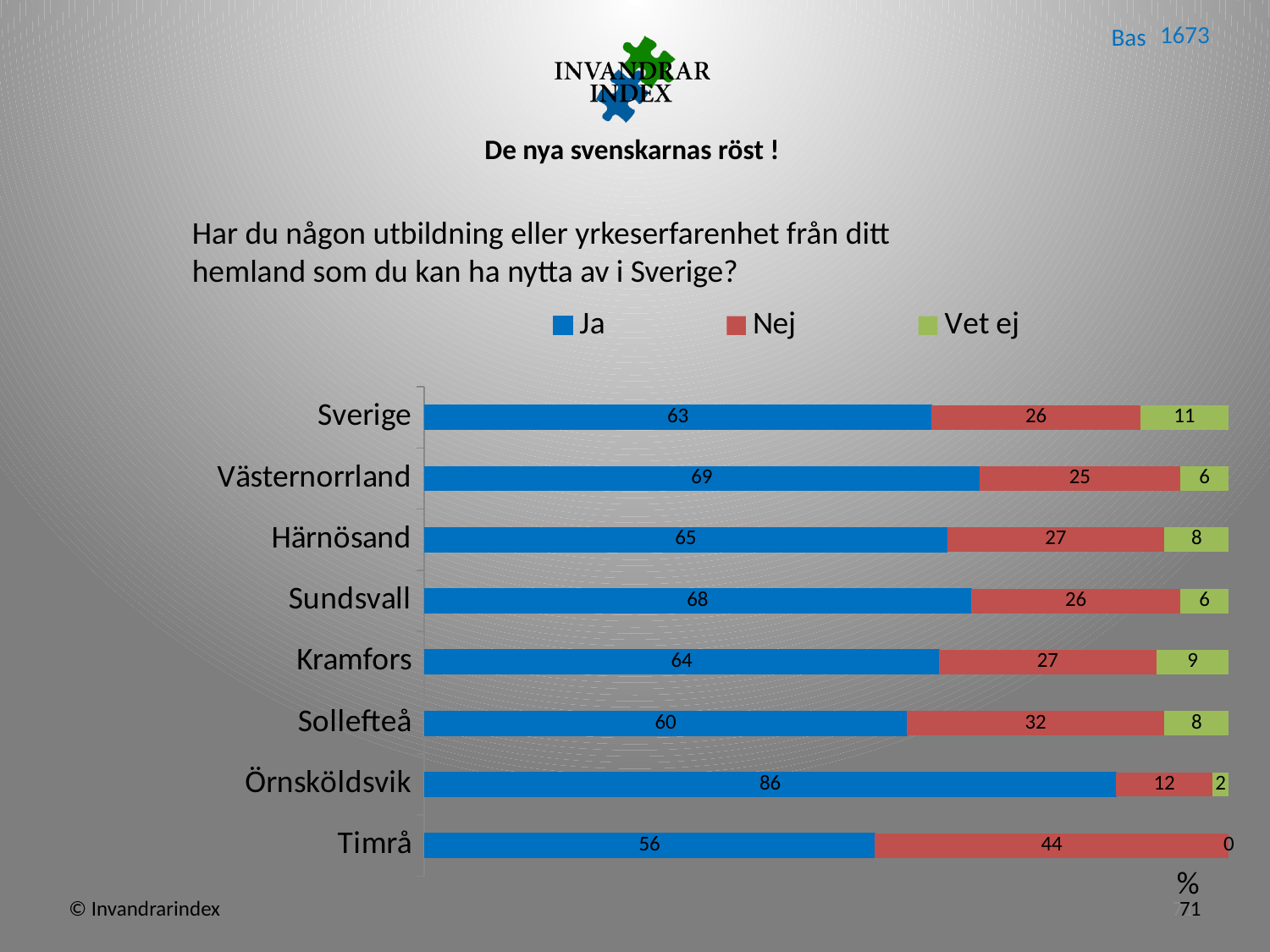
What is the "Vet ej" value for Sverige? 11 Which category has the lowest "Ja" value? Timrå What is the "Ja" value for Örnsköldsvik? 86 Which category has the highest "Ja" value? Örnsköldsvik What is the total of the stacked bar for Kramfors? 100 What kind of chart is shown on the slide? Stacked bar chart What is the "Nej" value for Sollefteå? 32 Which is larger, the "Ja" value for Västernorrland or for Härnösand? Västernorrland How many series does the legend list? 3 What is the difference between the "Nej" values for Timrå and Örnsköldsvik? 32 Which series is shown in green in the legend? Vet ej How many categories are shown on the chart? 8